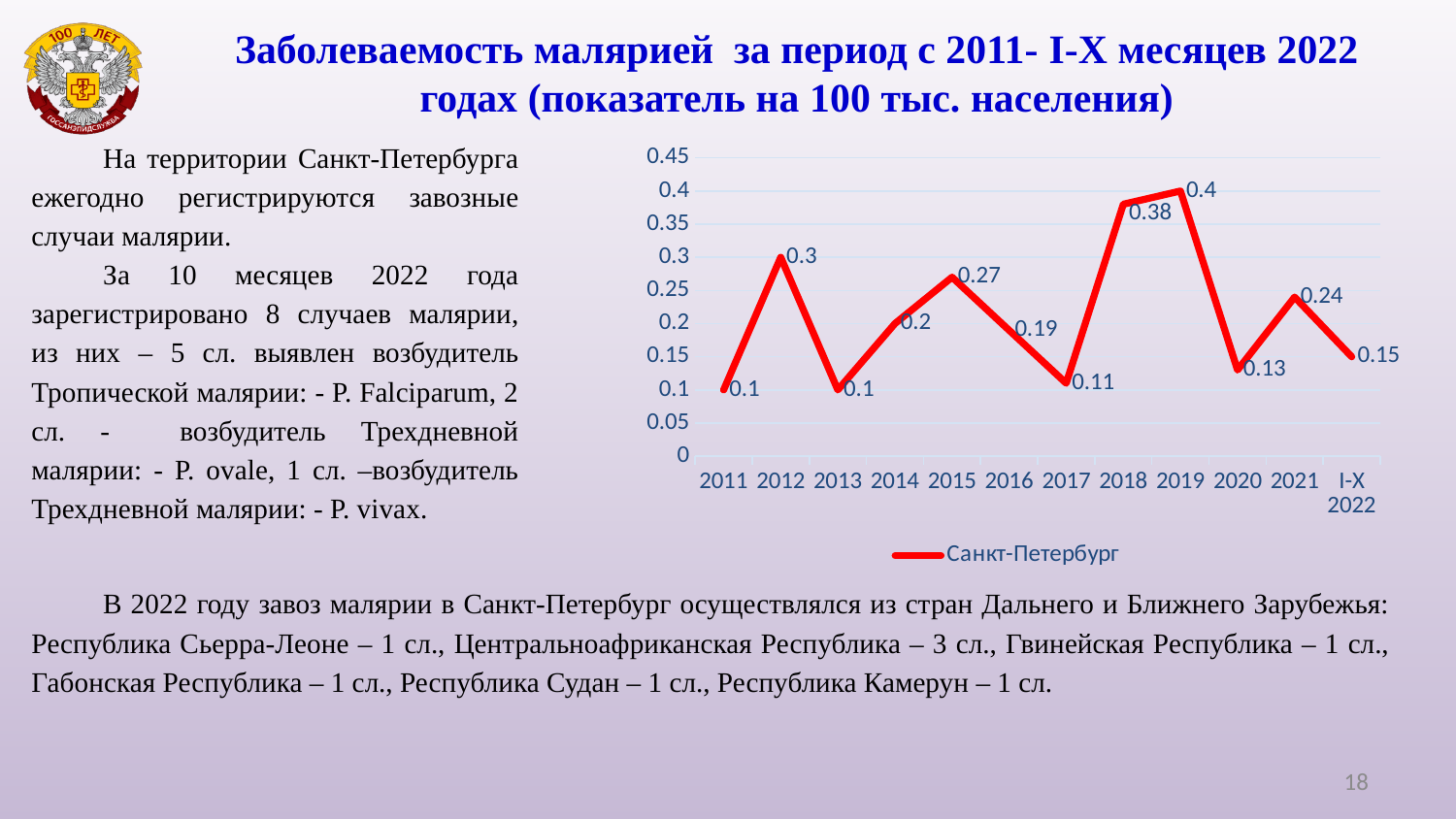
How many series does the legend list? 1 What is the name of the series shown in the legend? Санкт-Петербург What is the difference between the values for 2019 and 2020? 0.27 What is the value plotted for 2018? 0.38 What type of chart is shown on the slide? line chart What is the malaria incidence value for 2019? 0.4 Is the value for 2017 greater or less than 0.15? less What is the value plotted for I-X 2022? 0.15 Which is larger, the value for 2012 or the value for 2021? 2012 How many data points are plotted on the chart? 12 What is the value plotted for 2015? 0.27 Which year has the highest value on the chart? 2019